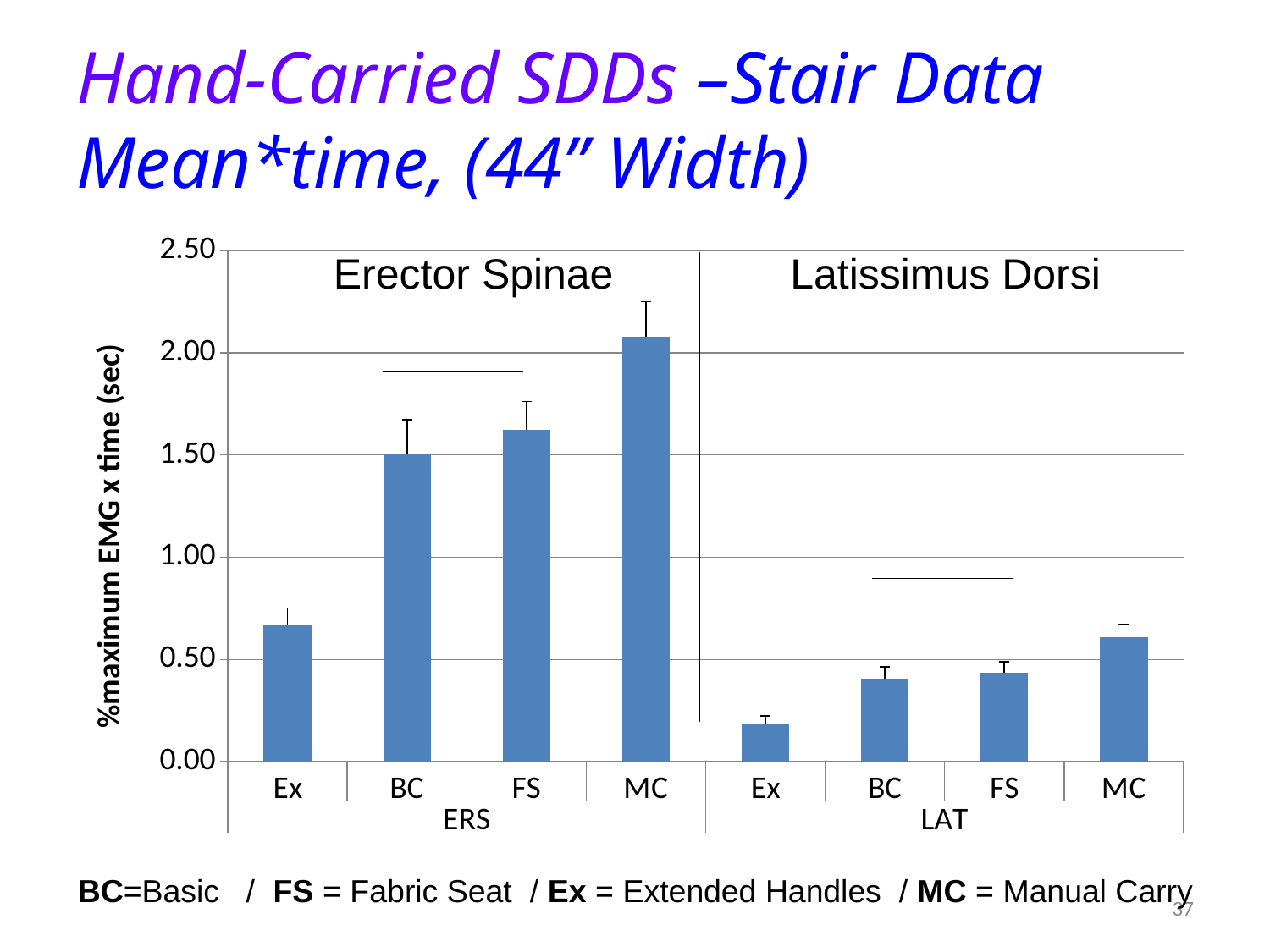
Which bar has the lowest value in the chart? Ex under LAT How many bars are plotted in the chart? 8 Is the value for MC in the LAT group greater or less than 0.50? greater What is the label on the vertical axis of the chart? %maximum EMG x time (sec) Which is larger, the value for BC in the ERS group or the value for BC in the LAT group? BC in the ERS group Is the value for MC in the ERS group greater or less than 1.50? greater Which is larger, the value for MC in the ERS group or the value for FS in the ERS group? MC in the ERS group What kind of chart is shown on the slide? bar chart Which bar has the highest value in the chart? MC under ERS Is the value for Ex in the LAT group greater or less than 0.50? less